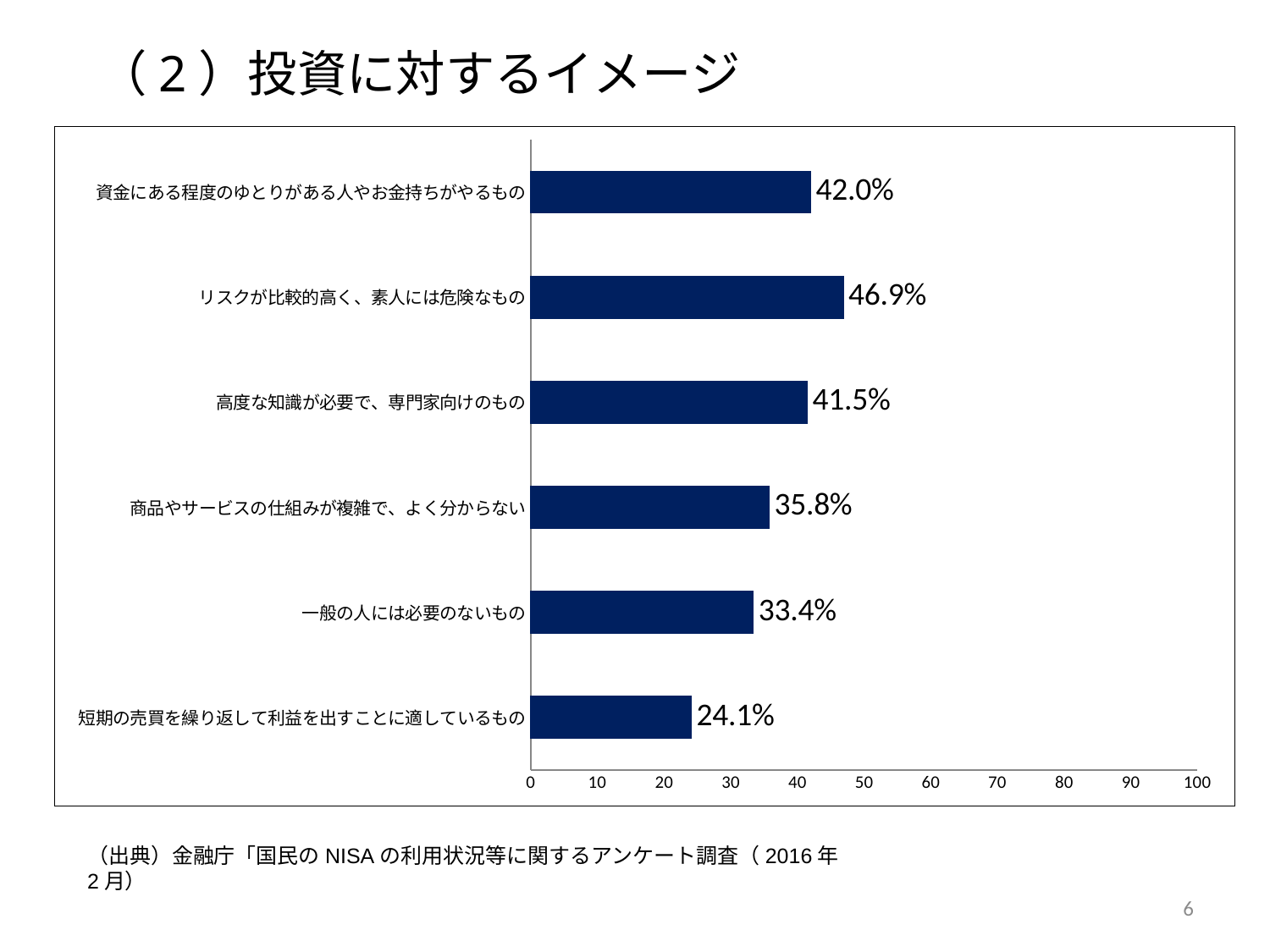
What is the value for 「短期の売買を繰り返して利益を出すことに適しているもの」? 24.1% What is the value for 「リスクが比較的高く、素人には危険なもの」? 46.9% What is the value for 「商品やサービスの仕組みが複雑で、よく分からない」? 35.8% Which category has the highest value? リスクが比較的高く、素人には危険なもの Is the value for 「一般の人には必要のないもの」 greater or less than 40? less How many categories are shown in the chart? 6 Which is larger, the value for 「高度な知識が必要で、専門家向けのもの」 or the value for 「商品やサービスの仕組みが複雑で、よく分からない」? 高度な知識が必要で、専門家向けのもの What is the maximum value shown on the horizontal axis? 100 Which category has the lowest value? 短期の売買を繰り返して利益を出すことに適しているもの What is the title of the slide? （２）投資に対するイメージ What kind of chart is shown on the slide? bar chart What is the difference between the values for 「資金にある程度のゆとりがある人やお金持ちがやるもの」 and 「一般の人には必要のないもの」? 8.6%